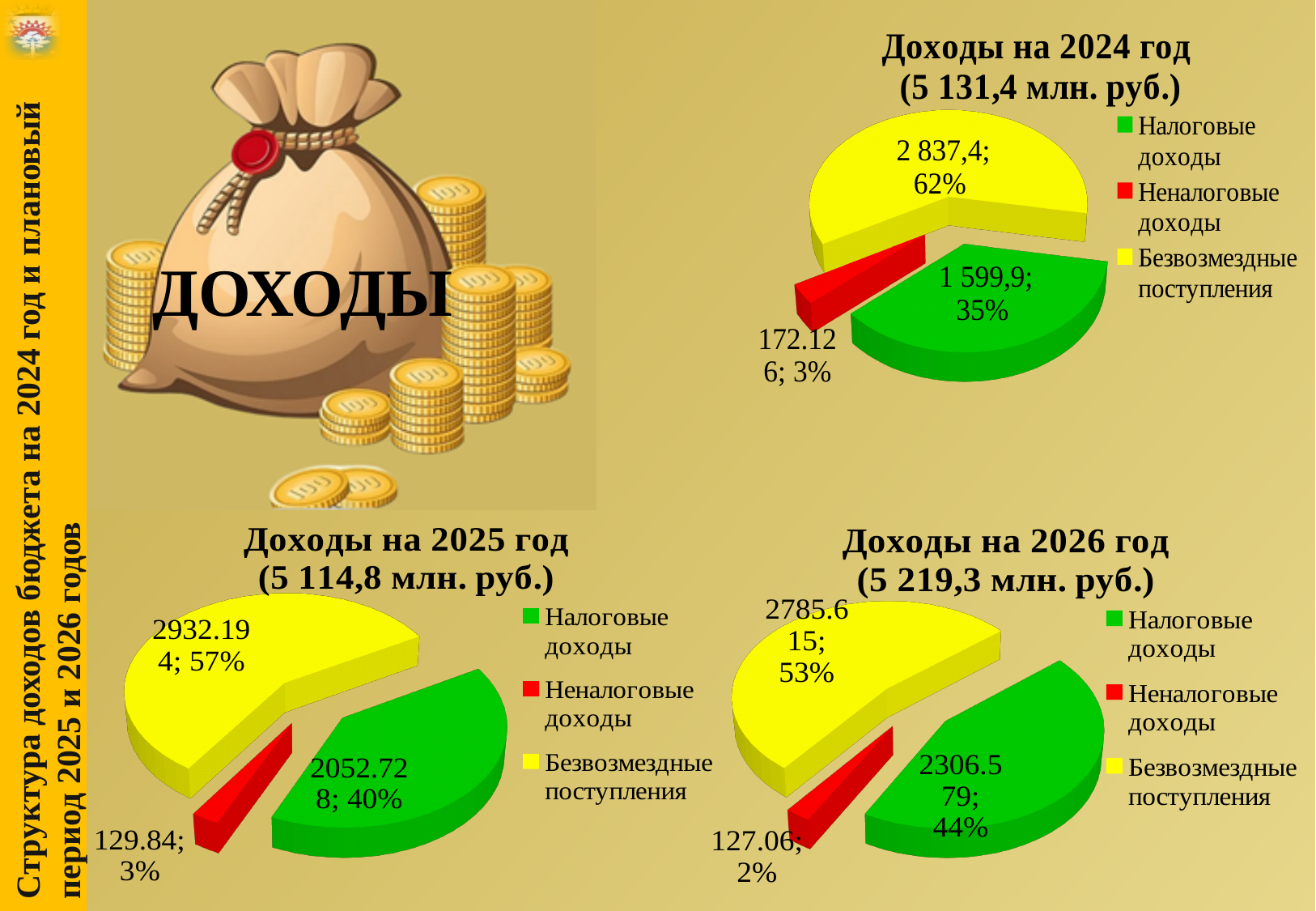
In the chart 'Доходы на 2025 год', which category has the largest slice? Безвозмездные поступления In the chart 'Доходы на 2026 год', what value is shown for Неналоговые доходы? 127.06 How many categories does the legend of the chart 'Доходы на 2025 год' list? 3 In the chart 'Доходы на 2026 год', which is larger: Налоговые доходы or Безвозмездные поступления? Безвозмездные поступления In the chart 'Доходы на 2024 год', what is the share of Безвозмездные поступления? 62% In the chart 'Доходы на 2025 год', what value is shown for Безвозмездные поступления? 2932.194 In the chart 'Доходы на 2024 год', which category has the smallest slice? Неналоговые доходы In the chart 'Доходы на 2026 год', what is the share of Безвозмездные поступления? 53% In the chart 'Доходы на 2024 год', what value is shown for Налоговые доходы? 1 599,9 In the chart 'Доходы на 2025 год', what is the share of Налоговые доходы? 40% In the chart 'Доходы на 2026 год', which colour represents Неналоговые доходы? Red What type of chart is 'Доходы на 2024 год'? Pie chart